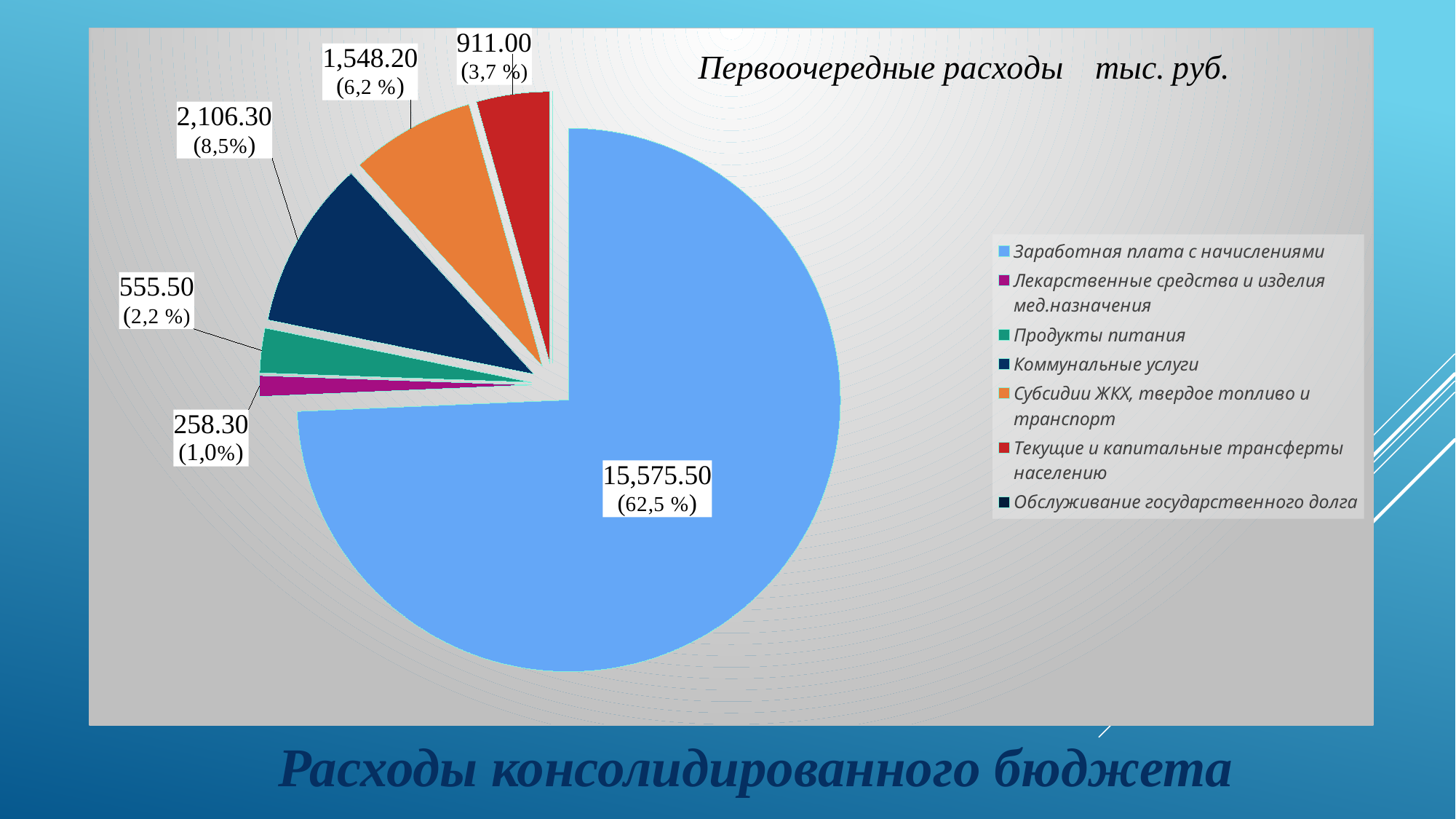
How many entries does the chart legend list? 7 What is the title of the chart? Первоочередные расходы тыс. руб. What share of the pie does Коммунальные услуги represent? 8,5% What is the value for Лекарственные средства и изделия мед.назначения? 258.30 What is the value for Коммунальные услуги? 2,106.30 What is the value for Заработная плата с начислениями? 15,575.50 Which labelled slice has the smallest value? Лекарственные средства и изделия мед.назначения Which is larger: the value for Текущие и капитальные трансферты населению or the value for Продукты питания? Текущие и капитальные трансферты населению What is the difference between the values for Коммунальные услуги and Субсидии ЖКХ, твердое топливо и транспорт? 558.10 What kind of chart is shown on the slide? pie chart Which category has the largest slice of the pie? Заработная плата с начислениями What is the value for Субсидии ЖКХ, твердое топливо и транспорт? 1,548.20